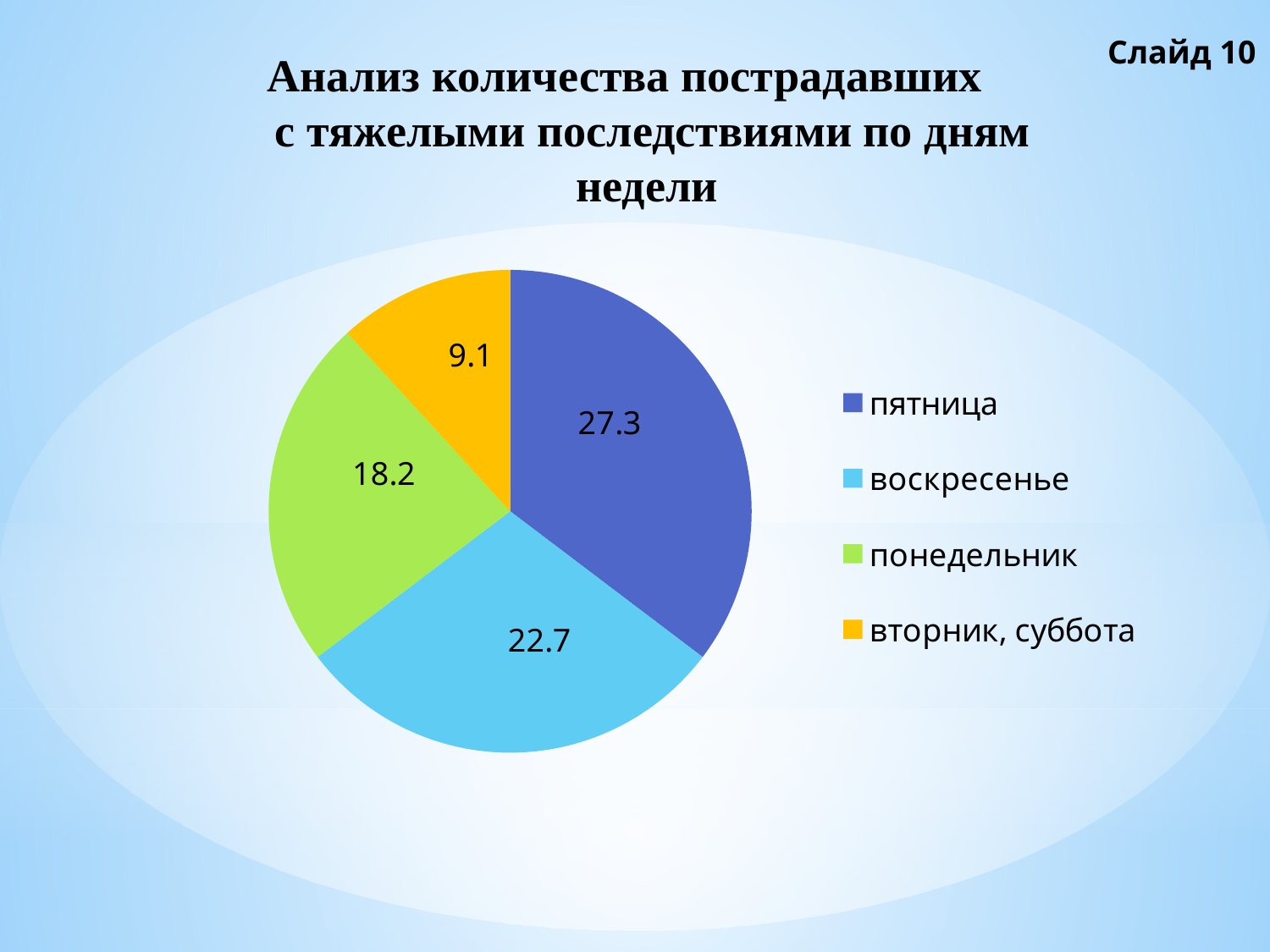
What is the difference between the values for пятница and воскресенье? 4.6 What is the value shown for понедельник? 18.2 Which is larger, the value for воскресенье or the value for понедельник? воскресенье Which category has the smallest slice of the pie? вторник, суббота How many categories does the pie chart have? 4 What is the difference between the values for понедельник and вторник, суббота? 9.1 What colour is the slice for понедельник? green What type of chart is shown on the slide? pie chart What is the value shown for воскресенье? 22.7 What is the value shown for пятница? 27.3 Which category has the largest slice of the pie? пятница What is the value shown for вторник, суббота? 9.1